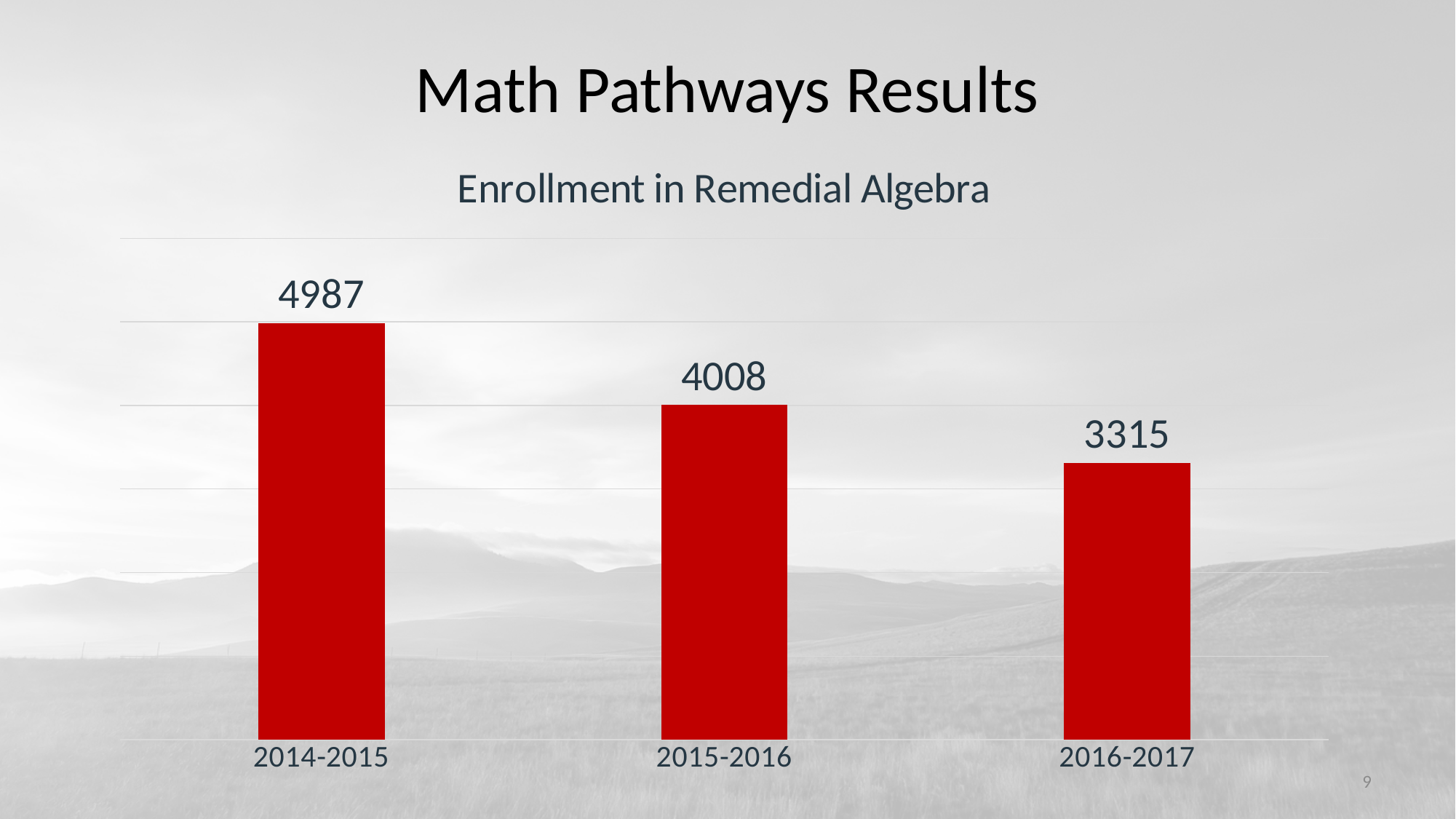
Does enrollment in remedial algebra rise or fall from 2014-2015 to 2016-2017? Fall What is the enrollment in remedial algebra for 2014-2015? 4987 What is the title of the chart? Enrollment in Remedial Algebra What is the enrollment in remedial algebra for 2016-2017? 3315 What kind of chart is shown on the slide? Bar chart Which academic year has the highest enrollment in remedial algebra? 2014-2015 Which academic year has the lowest enrollment in remedial algebra? 2016-2017 What is the difference in enrollment between 2014-2015 and 2015-2016? 979 What is the enrollment in remedial algebra for 2015-2016? 4008 Which year has higher enrollment, 2015-2016 or 2016-2017? 2015-2016 What is the difference in enrollment between 2014-2015 and 2016-2017? 1672 How many academic years are shown in the chart? 3